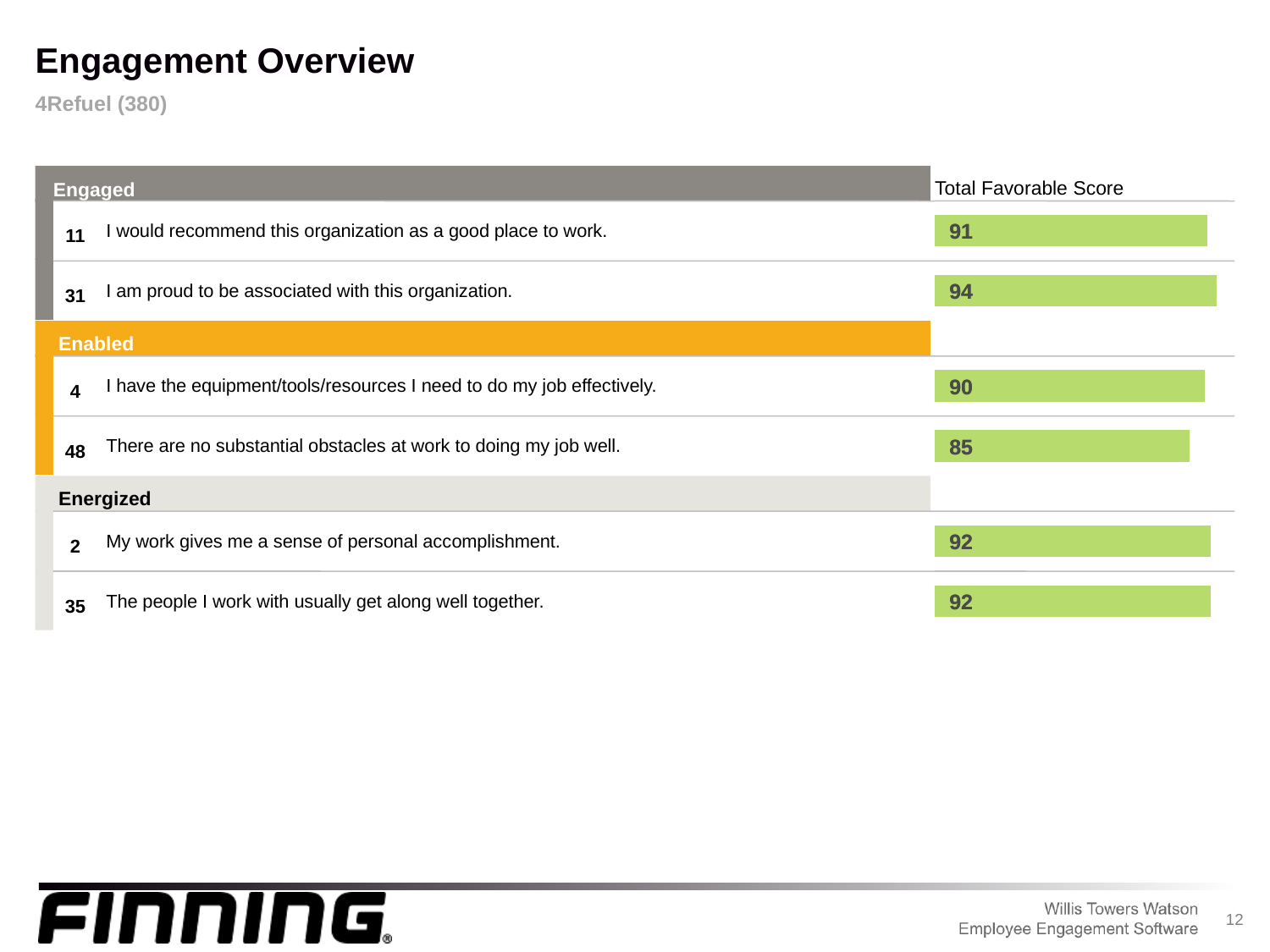
What is the difference between the Total Favorable Scores for "I am proud to be associated with this organization." and "There are no substantial obstacles at work to doing my job well."? 9 What is the Total Favorable Score for "There are no substantial obstacles at work to doing my job well."? 85 What are the three category headings under which the items are grouped? Engaged, Enabled, Energized What is the Total Favorable Score for "I am proud to be associated with this organization."? 94 What kind of chart is used to show the Total Favorable Scores? Bar chart What is the Total Favorable Score for "I would recommend this organization as a good place to work."? 91 What is the Total Favorable Score for "My work gives me a sense of personal accomplishment."? 92 Which item has the highest Total Favorable Score? I am proud to be associated with this organization. How many items are shown with a Total Favorable Score bar? 6 Which item has the lowest Total Favorable Score? There are no substantial obstacles at work to doing my job well. Which has a higher Total Favorable Score: "I would recommend this organization as a good place to work." or "I have the equipment/tools/resources I need to do my job effectively."? I would recommend this organization as a good place to work. What is the Total Favorable Score for "I have the equipment/tools/resources I need to do my job effectively."? 90